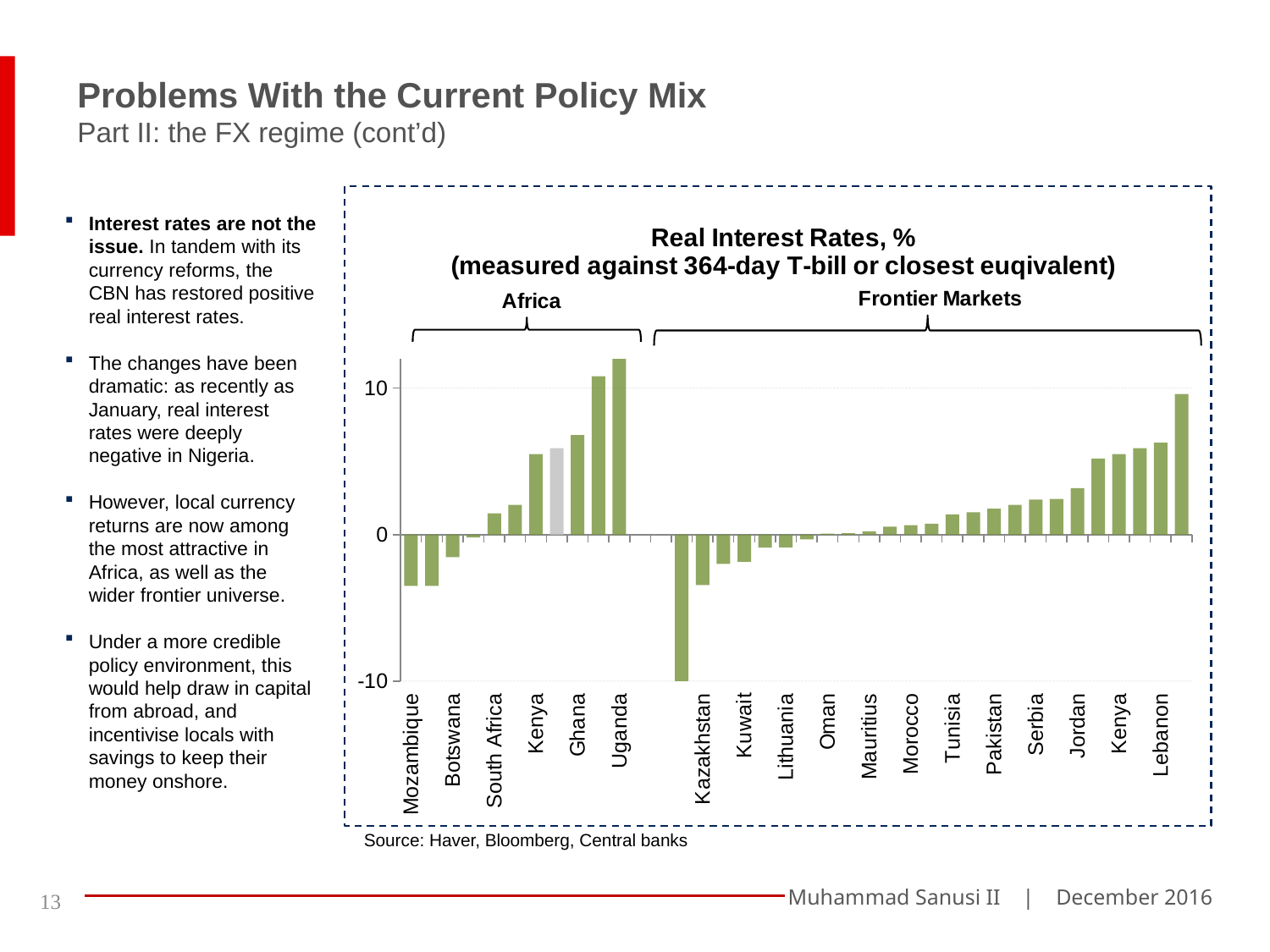
Which country has the highest real interest rate in the chart? Uganda Is the value for Mozambique greater or less than 0? less Is the value for Kazakhstan greater or less than -5? greater Is the value for Uganda greater or less than 10? greater Which has the higher real interest rate, Uganda or Lebanon? Uganda What is the title of the chart? Real Interest Rates, % What kind of chart is shown on the slide? Bar chart Within the Frontier Markets group, do the bars rise or fall from left to right? Rise Which two groups of countries are labelled above the chart? Africa and Frontier Markets